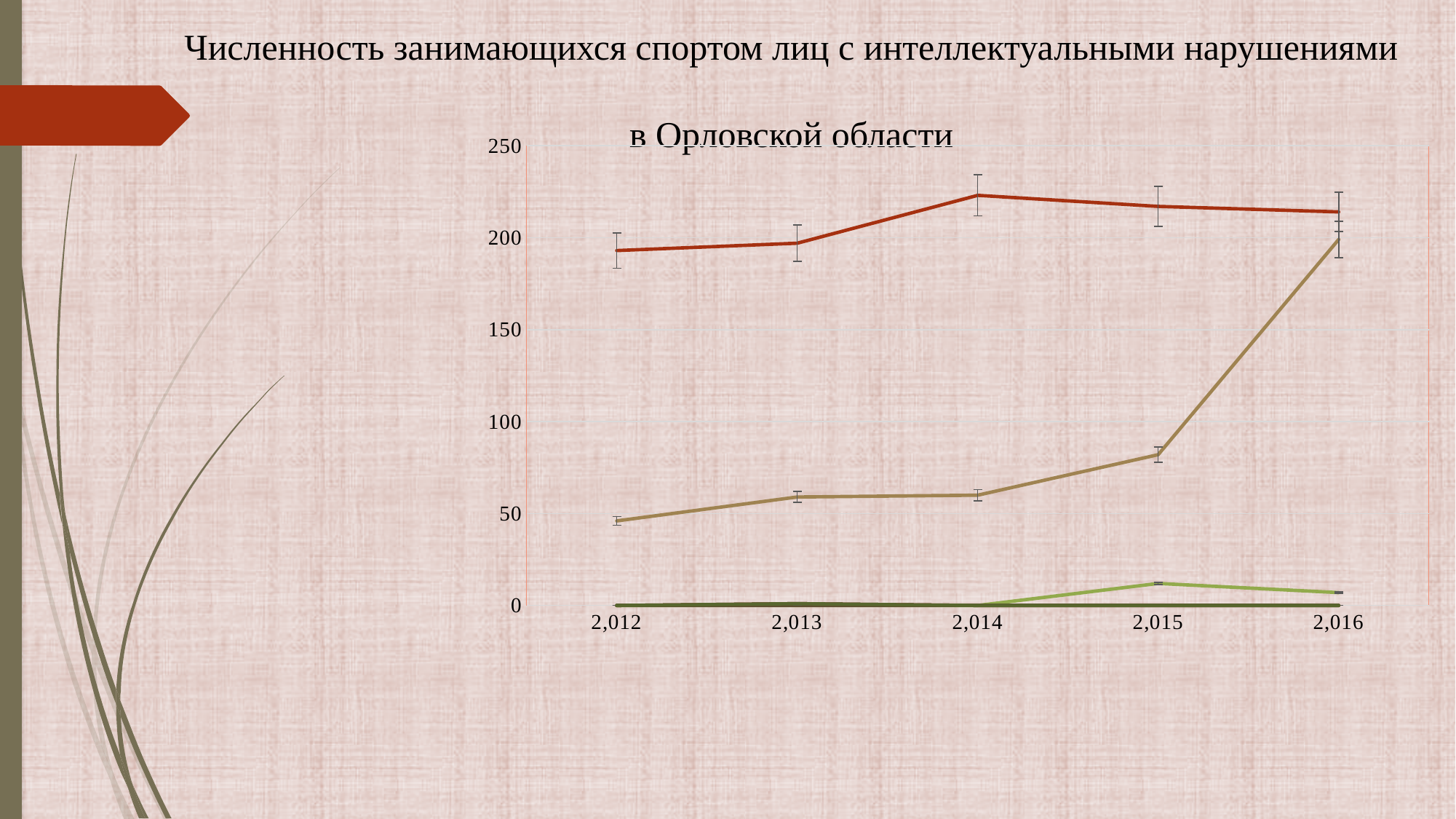
Is the value of the light green line in 2,015 greater or less than 50? less Is the value of the tan (brown) line in 2,015 greater or less than 100? less Is the value of the red line in 2,012 greater or less than 150? greater What is the first year shown on the x axis? 2,012 What kind of chart is shown on the slide? line chart Does the tan (brown) line rise or fall from 2,012 to 2,016? rise What is the last year shown on the x axis? 2,016 In which year does the tan (brown) line reach its highest value? 2,016 In 2,012, which line has the larger value, the red line or the tan (brown) line? the red line How many years are shown on the x axis of the chart? 5